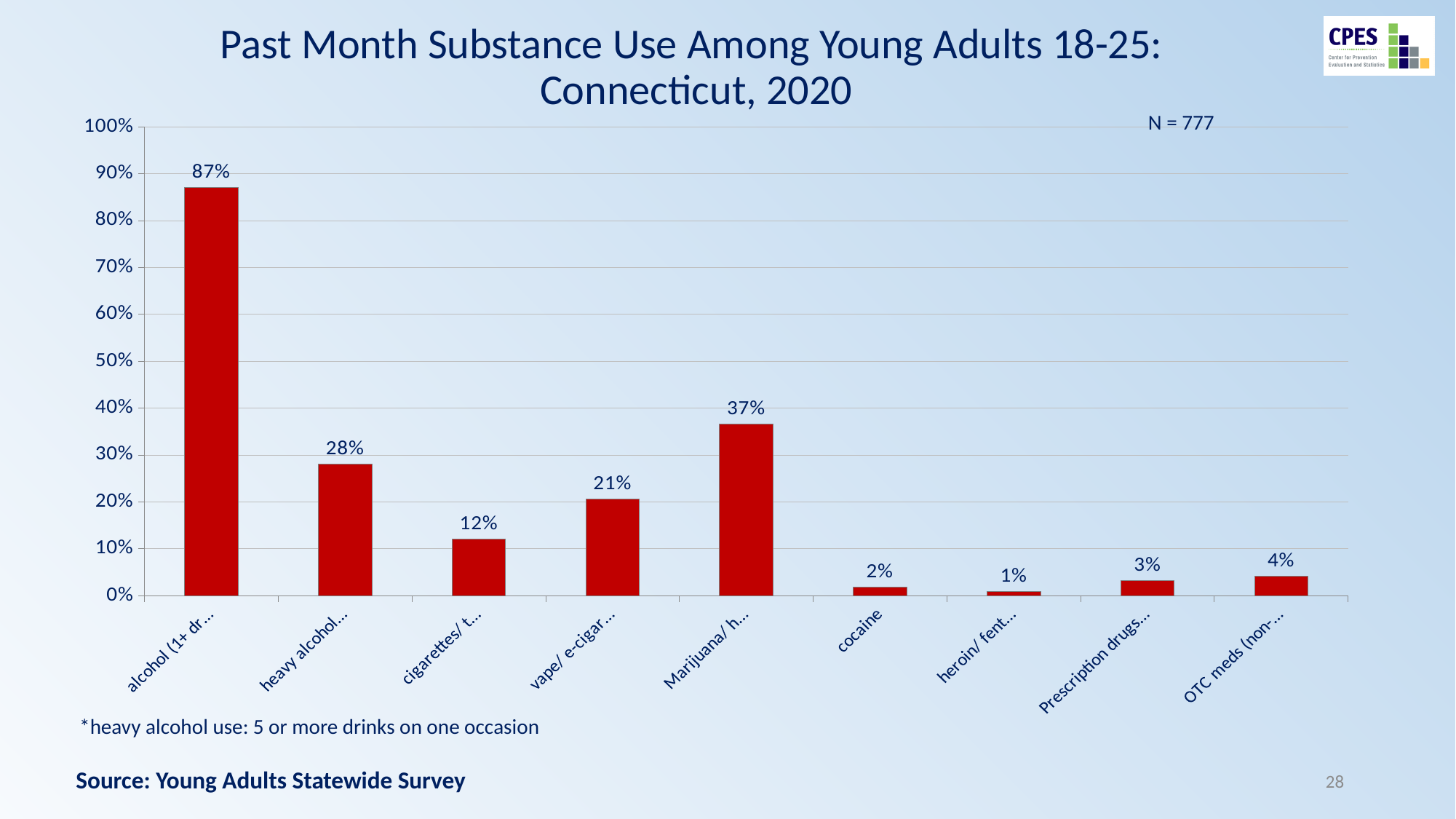
What is the value for the first bar, alcohol (1+ dr...)? 87% What is the difference between the heavy alcohol... value and the cigarettes/ t... value? 16% Is the value for the Marijuana/ h... category greater or less than 40%? less Which is larger, the value for Marijuana/ h... or the value for heavy alcohol...? Marijuana/ h... What is the value for the Marijuana/ h... category? 37% How many categories (bars) are shown in the chart? 9 What is the value for cocaine? 2% What is the value for the vape/ e-cigar... category? 21% Which category has the highest value? alcohol (1+ dr...) Which category has the lowest value? heroin/ fent... What sample size (N) is shown on the chart? N = 777 What kind of chart is shown on the slide? bar chart